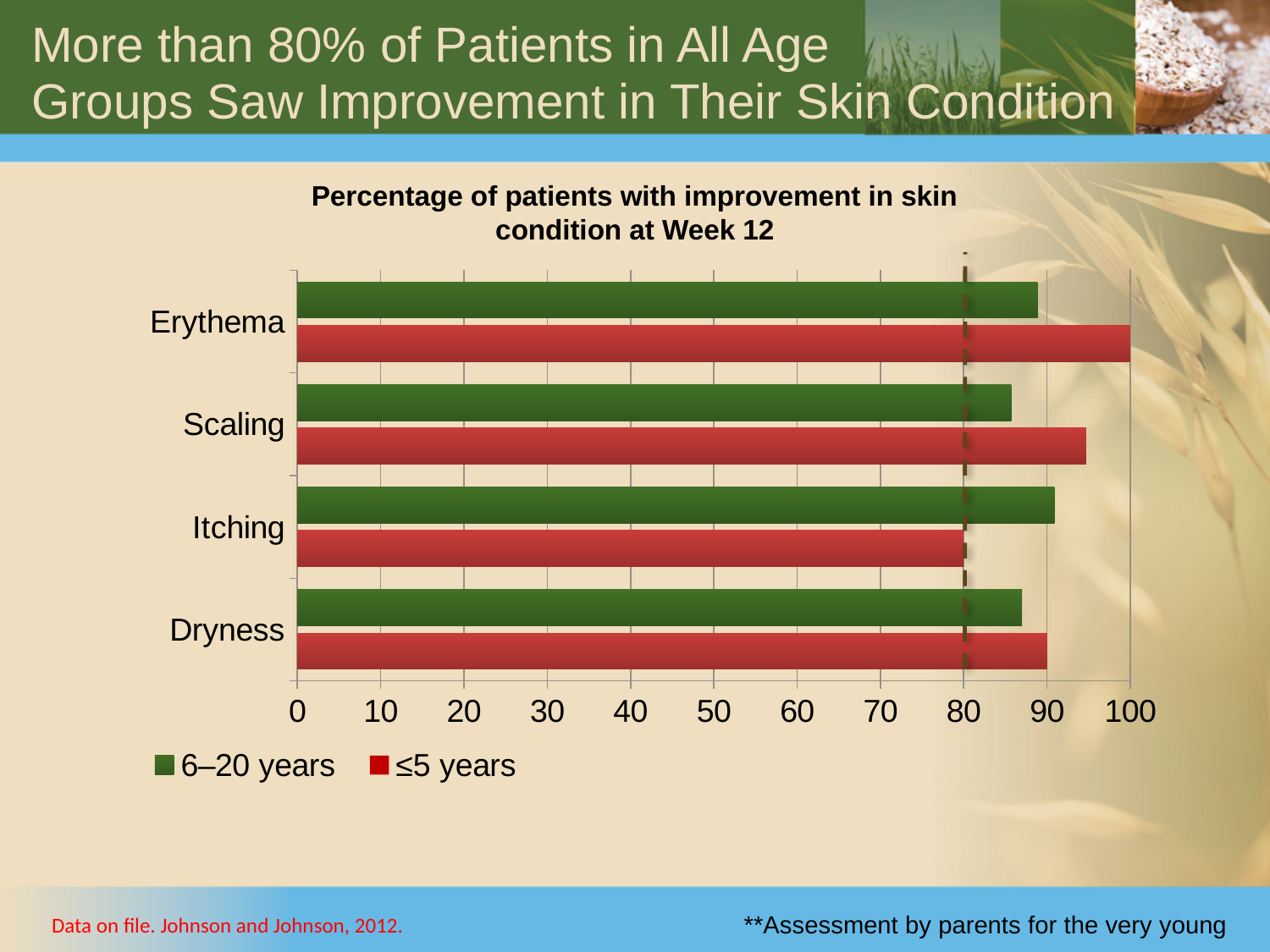
What is the value for Itching in the ≤5 years series? 80 What is the value for Dryness in the ≤5 years series? 90 Is the value for Dryness in the 6–20 years series greater or less than 90? less Which category has the highest value in the ≤5 years series? Erythema For Scaling, which age group has the larger value, 6–20 years or ≤5 years? ≤5 years How many series does the legend list? 2 How many skin condition categories are plotted on the chart? 4 What is the value for Erythema in the ≤5 years series? 100 Which category has the lowest value in the ≤5 years series? Itching For Itching, which age group has the larger value, 6–20 years or ≤5 years? 6–20 years Is the value for Scaling in the ≤5 years series greater or less than 90? greater What kind of chart is shown on the slide? bar chart